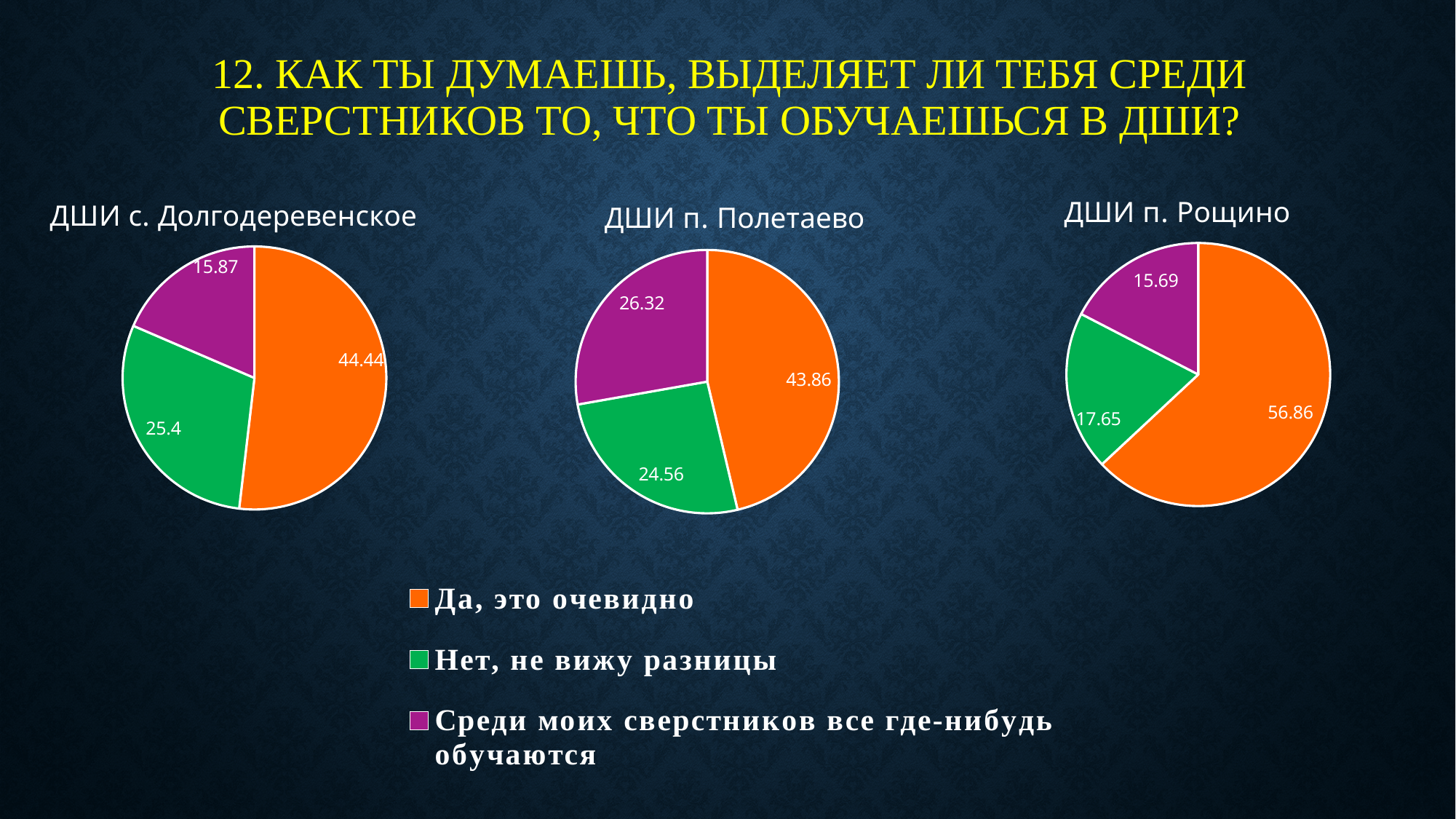
In the chart titled "ДШИ п. Рощино", which category has the largest slice? Да, это очевидно In the chart titled "ДШИ п. Рощино", what is the difference between the values for "Да, это очевидно" and "Среди моих сверстников все где-нибудь обучаются"? 41.17 How many pie charts are shown on the slide? 3 In the chart titled "ДШИ п. Рощино", what is the value for "Нет, не вижу разницы"? 17.65 Which is larger: the value for "Да, это очевидно" in the chart titled "ДШИ п. Рощино" or in the chart titled "ДШИ с. Долгодеревенское"? ДШИ п. Рощино In the chart titled "ДШИ с. Долгодеревенское", what is the value for "Да, это очевидно"? 44.44 In the chart titled "ДШИ п. Полетаево", what is the difference between the values for "Да, это очевидно" and "Нет, не вижу разницы"? 19.3 How many slices does the chart titled "ДШИ п. Полетаево" have? 3 In the chart titled "ДШИ п. Полетаево", what is the value for "Среди моих сверстников все где-нибудь обучаются"? 26.32 In the chart titled "ДШИ п. Полетаево", which is larger: "Нет, не вижу разницы" or "Среди моих сверстников все где-нибудь обучаются"? Среди моих сверстников все где-нибудь обучаются In the chart titled "ДШИ с. Долгодеревенское", which category has the smallest slice? Среди моих сверстников все где-нибудь обучаются What kind of chart is used for "ДШИ с. Долгодеревенское"? Pie chart